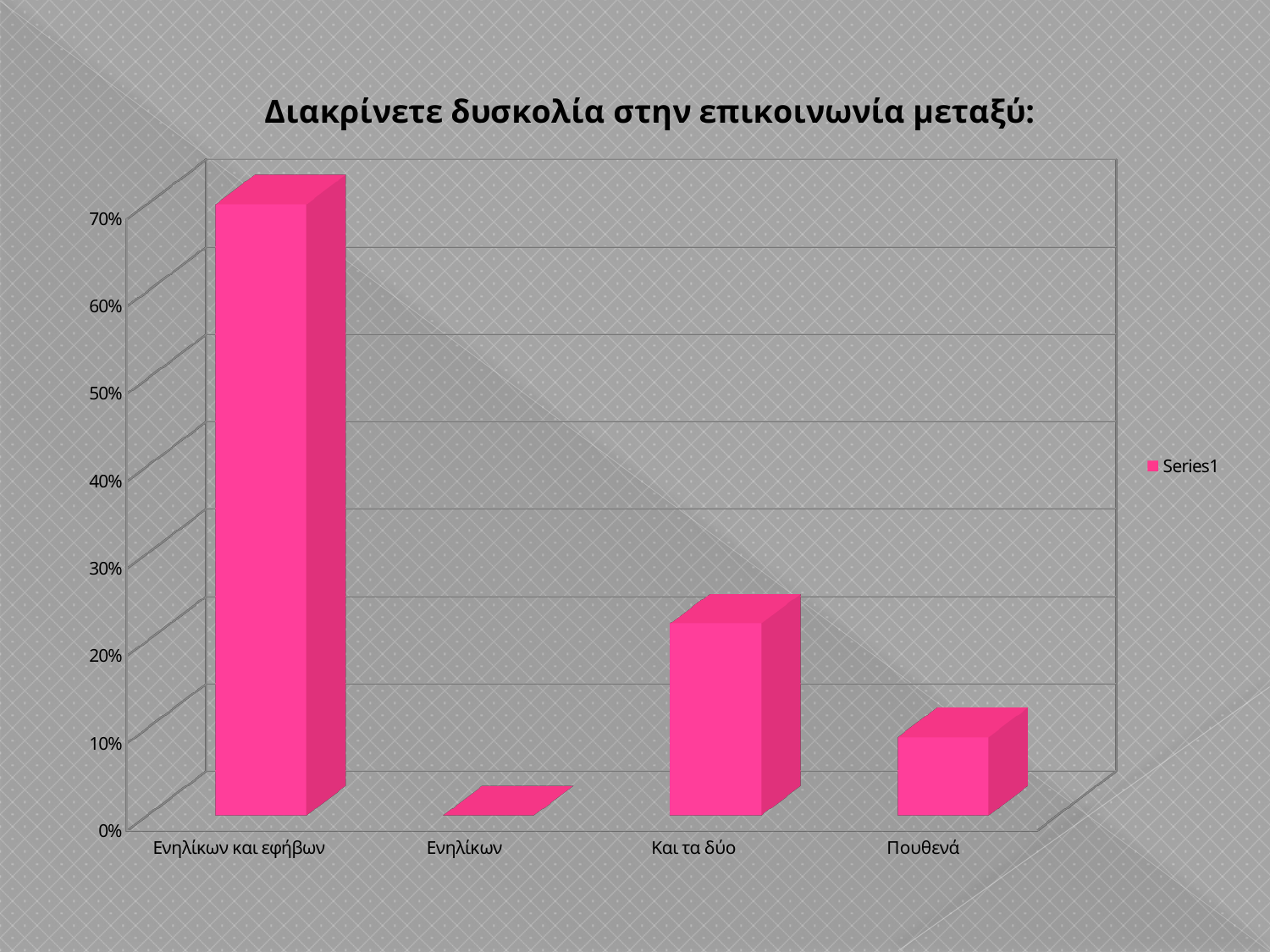
Which is larger, the value for Και τα δύο or the value for Πουθενά? Και τα δύο Is the value for Πουθενά greater or less than 20%? less Is the value for Ενηλίκων και εφήβων greater or less than 60%? greater Which is larger, the value for Ενηλίκων και εφήβων or the value for Και τα δύο? Ενηλίκων και εφήβων Which category has the lowest value? Ενηλίκων Which category has the highest value? Ενηλίκων και εφήβων What kind of chart is shown on the slide? bar chart Is the value for Και τα δύο greater or less than 30%? less How many series does the legend list? 1 What is the title of the chart? Διακρίνετε δυσκολία στην επικοινωνία μεταξύ: What is the value for Ενηλίκων? 0% How many categories are shown on the x axis of the chart? 4